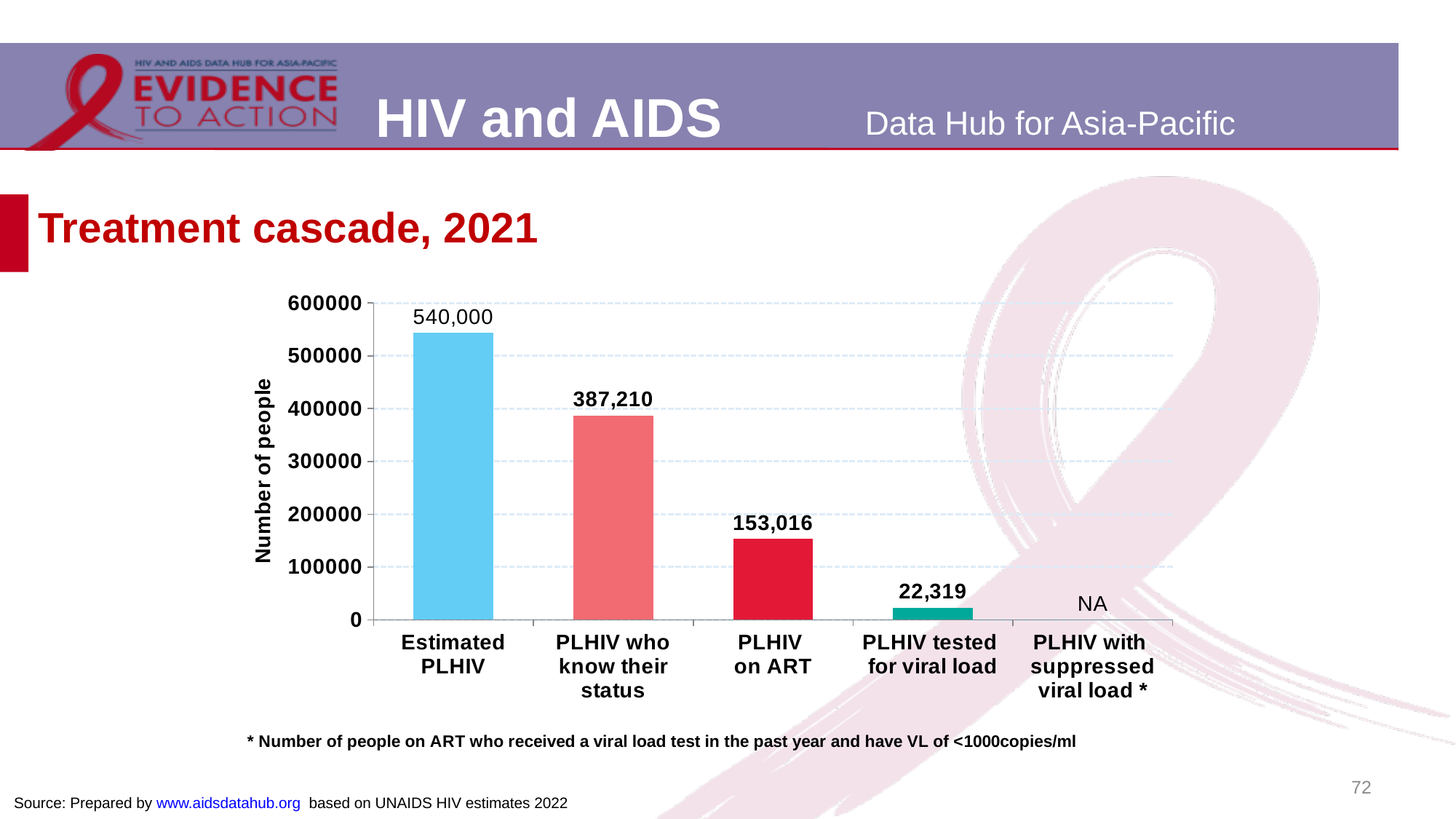
Which category with a plotted value has the lowest value? PLHIV tested for viral load How many categories are shown on the x axis? 5 What is shown for PLHIV with suppressed viral load? NA What is the value for PLHIV who know their status? 387,210 What is the difference between Estimated PLHIV and PLHIV who know their status? 152,790 What is the value for PLHIV tested for viral load? 22,319 What is the difference between PLHIV on ART and PLHIV tested for viral load? 130,697 Which category has the highest value? Estimated PLHIV What kind of chart is this? Bar chart What is the value for PLHIV on ART? 153,016 What is the value for Estimated PLHIV? 540,000 Which is larger, PLHIV who know their status or PLHIV on ART? PLHIV who know their status